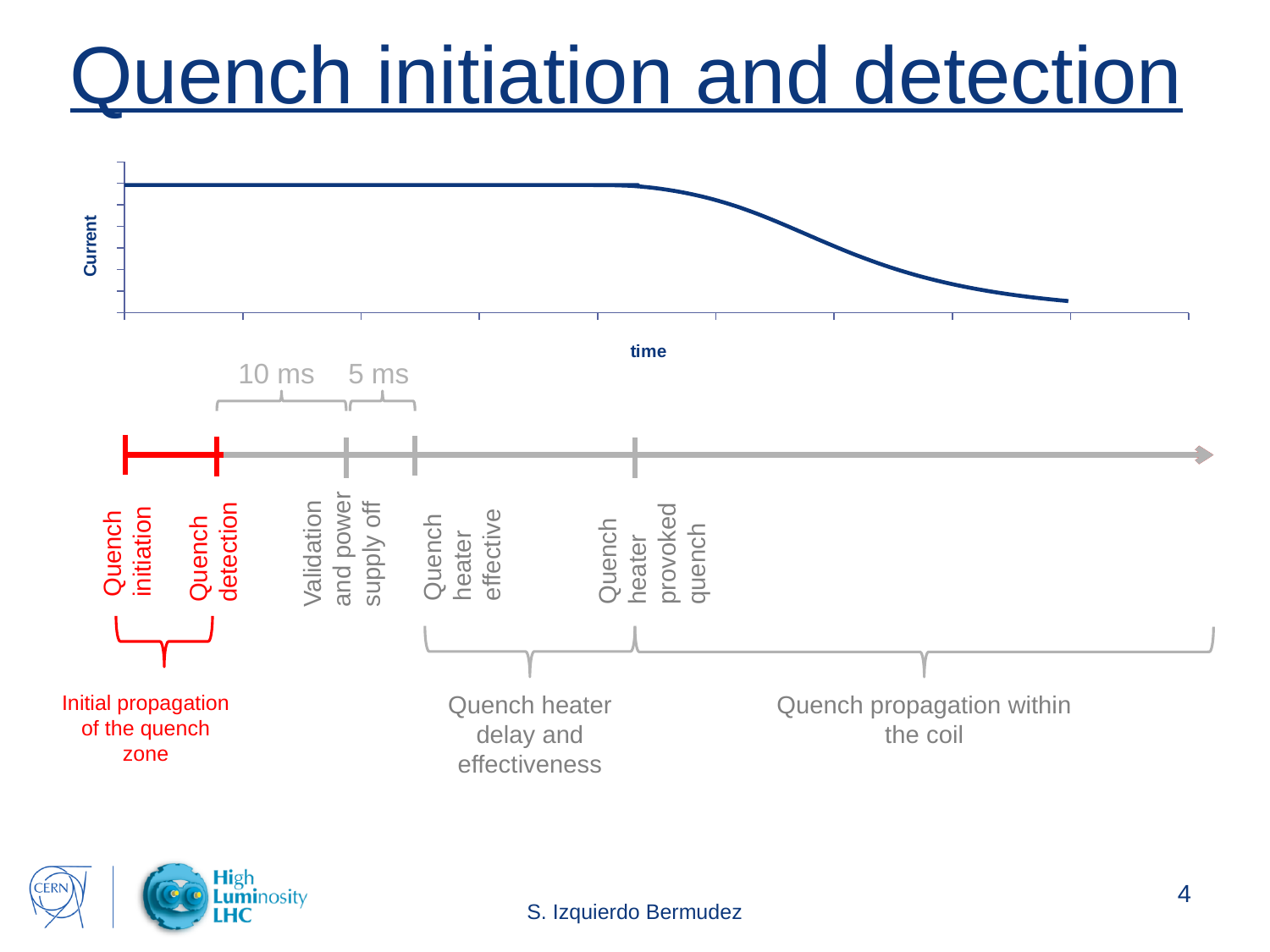
What is the label on the vertical axis of the chart? Current What kind of chart is shown at the top of the slide? line chart How many lines (series) are plotted on the chart? 1 What is the label on the horizontal axis of the chart? time Does the current rise or fall along the time axis after the initial flat section? fall